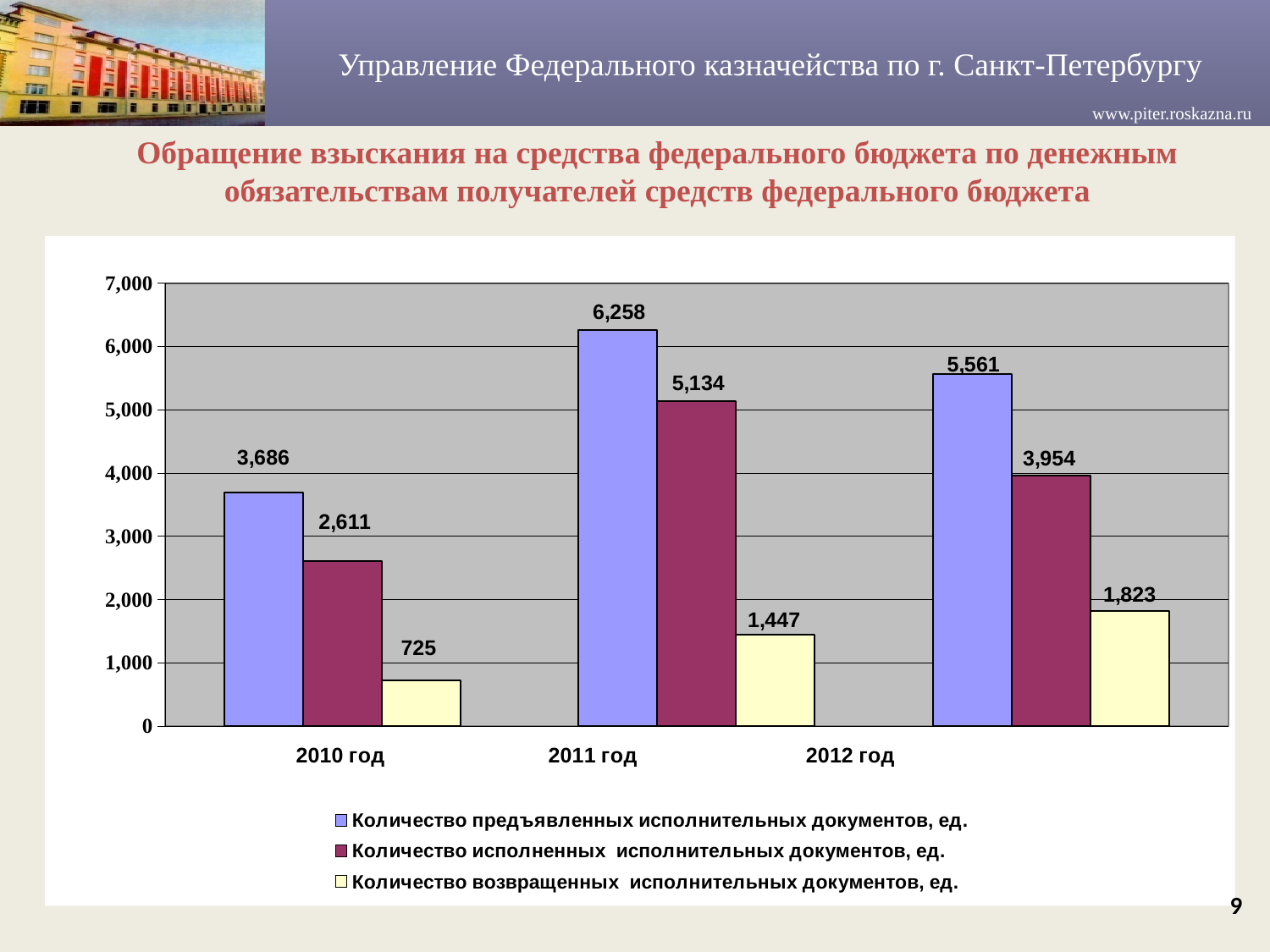
What is the value of 'Количество исполненных исполнительных документов, ед.' for 2012 год? 3,954 What colour are the bars for 'Количество возвращенных исполнительных документов, ед.'? light yellow How many series does the legend list? 3 Does 'Количество возвращенных исполнительных документов, ед.' rise or fall from 2010 год to 2012 год? rise What is the value of 'Количество предъявленных исполнительных документов, ед.' for 2011 год? 6,258 In which year is 'Количество предъявленных исполнительных документов, ед.' highest? 2011 год What is the difference between 'Количество предъявленных исполнительных документов, ед.' and 'Количество исполненных исполнительных документов, ед.' in 2012 год? 1,607 What type of chart is shown on the slide? bar chart How many year categories are shown on the x axis? 3 What is the value of 'Количество возвращенных исполнительных документов, ед.' for 2010 год? 725 In which year is 'Количество возвращенных исполнительных документов, ед.' lowest? 2010 год Which is larger: 'Количество исполненных исполнительных документов, ед.' in 2011 год or 'Количество предъявленных исполнительных документов, ед.' in 2012 год? Количество предъявленных исполнительных документов, ед. in 2012 год